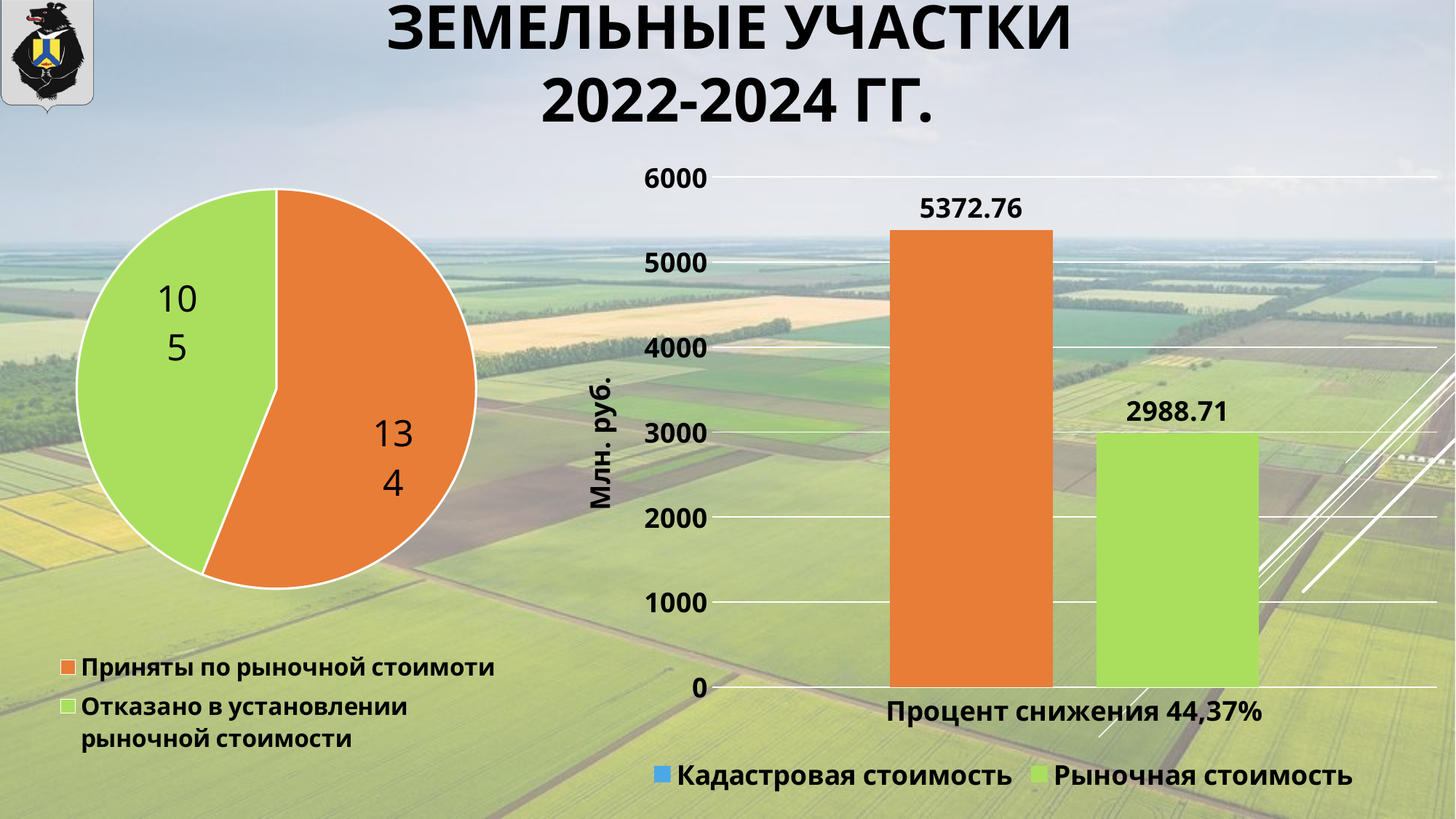
What kind of chart is shown on the right side of the slide? bar chart On the bar chart on the right, what is the value for Рыночная стоимость? 2988.71 On the pie chart on the left, which slice is larger: Приняты по рыночной стоимоти or Отказано в установлении рыночной стоимости? Приняты по рыночной стоимоти On the pie chart on the left, what is the value for Отказано в установлении рыночной стоимости? 105 On the bar chart on the right, what is the label on the vertical axis? Млн. руб. On the bar chart on the right, what is the value for Кадастровая стоимость? 5372.76 On the bar chart on the right, how many series does the legend list? 2 On the bar chart on the right, what is the difference between Кадастровая стоимость and Рыночная стоимость? 2384.05 On the pie chart on the left, what is the value for Приняты по рыночной стоимоти? 134 On the bar chart on the right, which series has the higher value? Кадастровая стоимость On the bar chart on the right, what is the category label shown under the bars? Процент снижения 44,37% What kind of chart is shown on the left side of the slide? pie chart